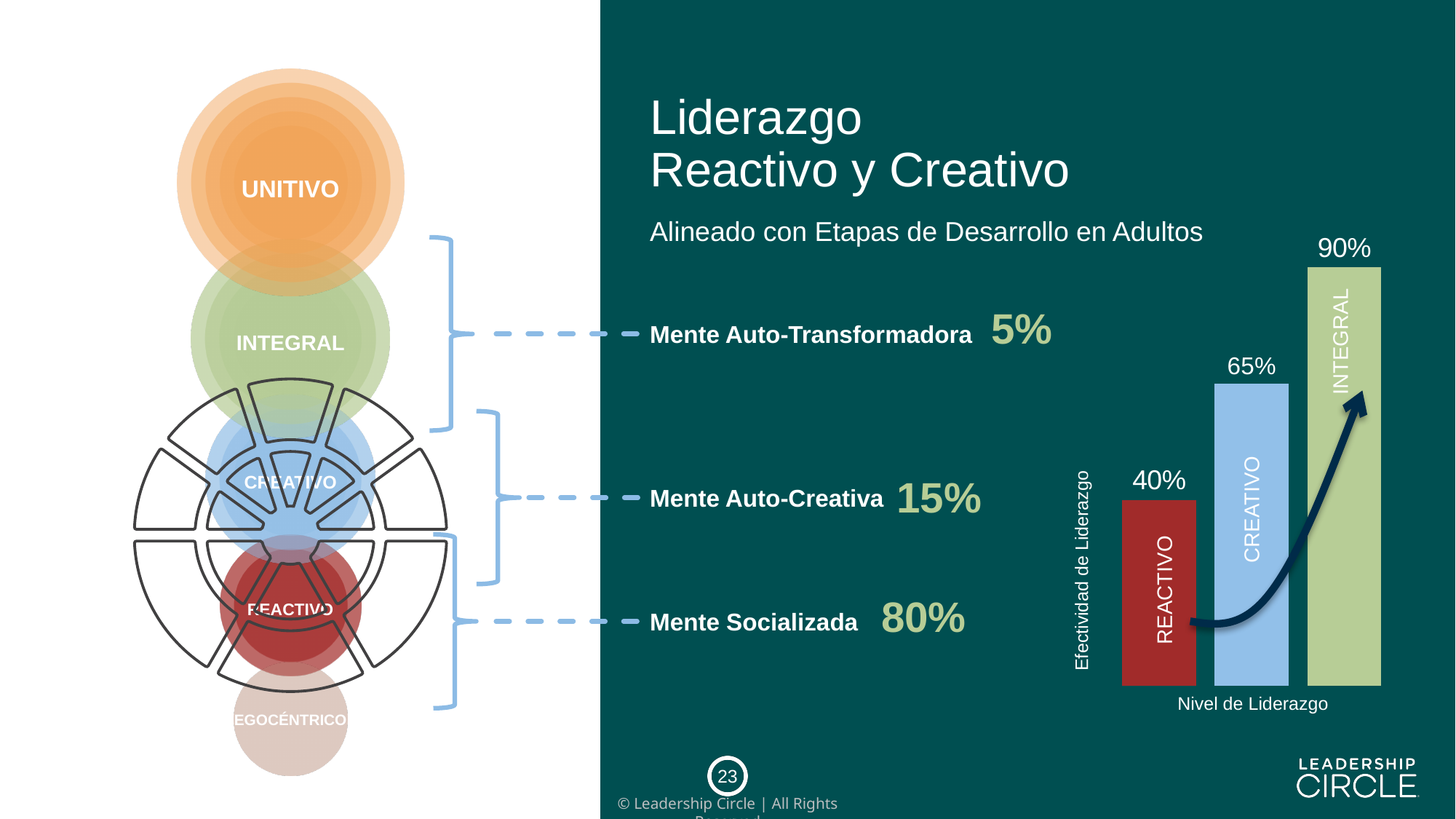
In the bar chart, what is the value for INTEGRAL? 90% In the bar chart, which is larger, the value for CREATIVO or the value for INTEGRAL? INTEGRAL How many bars are shown in the bar chart? 3 What is the label of the vertical axis of the bar chart? Efectividad de Liderazgo In the bar chart, what is the value for CREATIVO? 65% In the bar chart, which category has the highest value? INTEGRAL In the bar chart, what is the difference between the values for CREATIVO and REACTIVO? 25% In the bar chart, what is the difference between the values for INTEGRAL and REACTIVO? 50% What kind of chart is shown on the right side of the slide? Bar chart In the bar chart, what is the value for REACTIVO? 40% In the bar chart, do the values rise or fall from REACTIVO to INTEGRAL? Rise In the bar chart, which category has the lowest value? REACTIVO